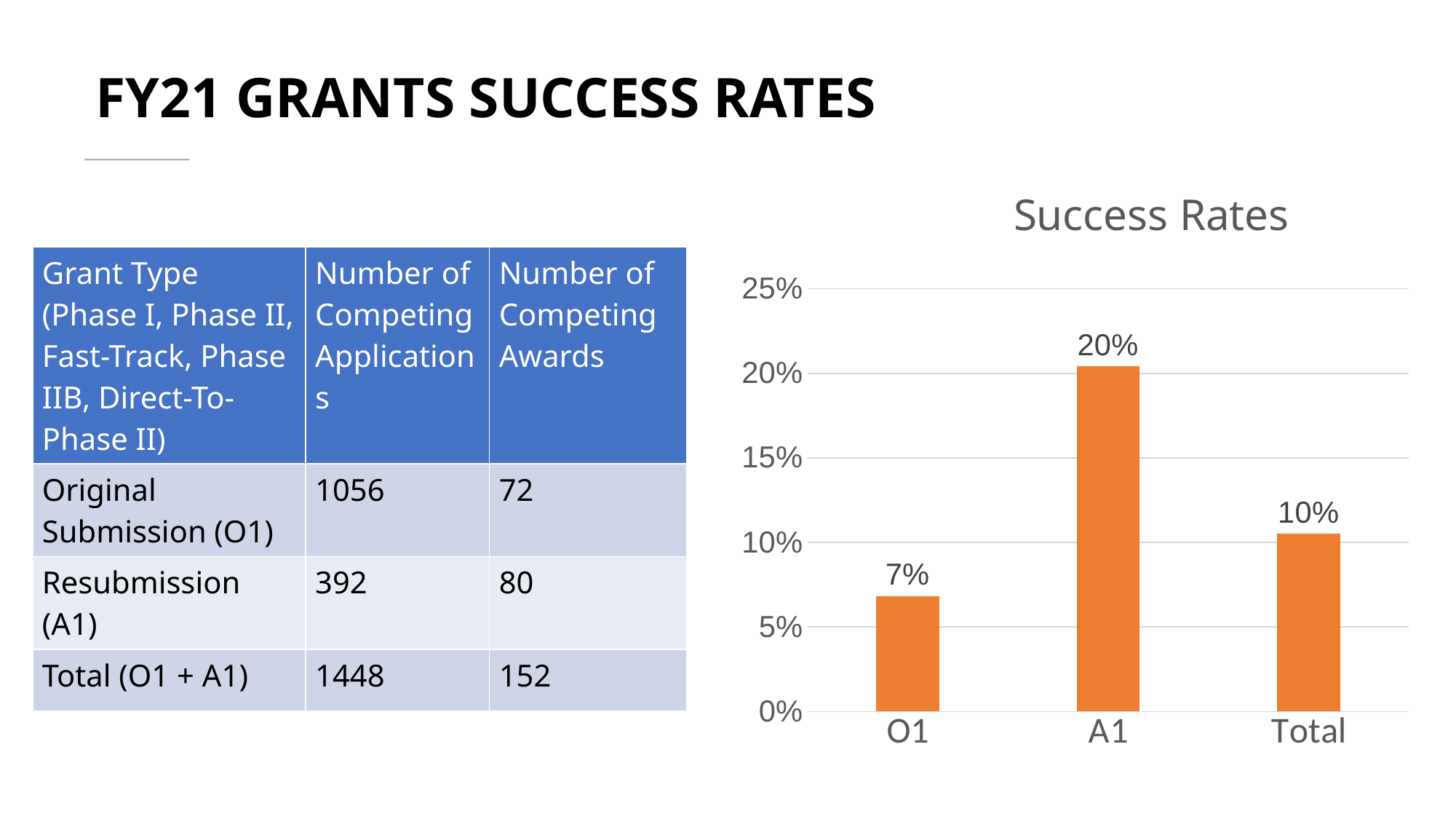
What is the success rate for Total? 10% Which category has the lowest success rate? O1 What is the difference between the success rates for A1 and O1? 13% Which has a higher success rate, O1 or Total? Total What kind of chart is shown on the slide? bar chart What colour are the bars in the chart? orange What is the success rate for A1? 20% What is the title of the chart? Success Rates Which category has the highest success rate? A1 What is the success rate for O1? 7% Is the value for A1 greater or less than 15%? greater How many categories are shown on the x axis of the chart? 3